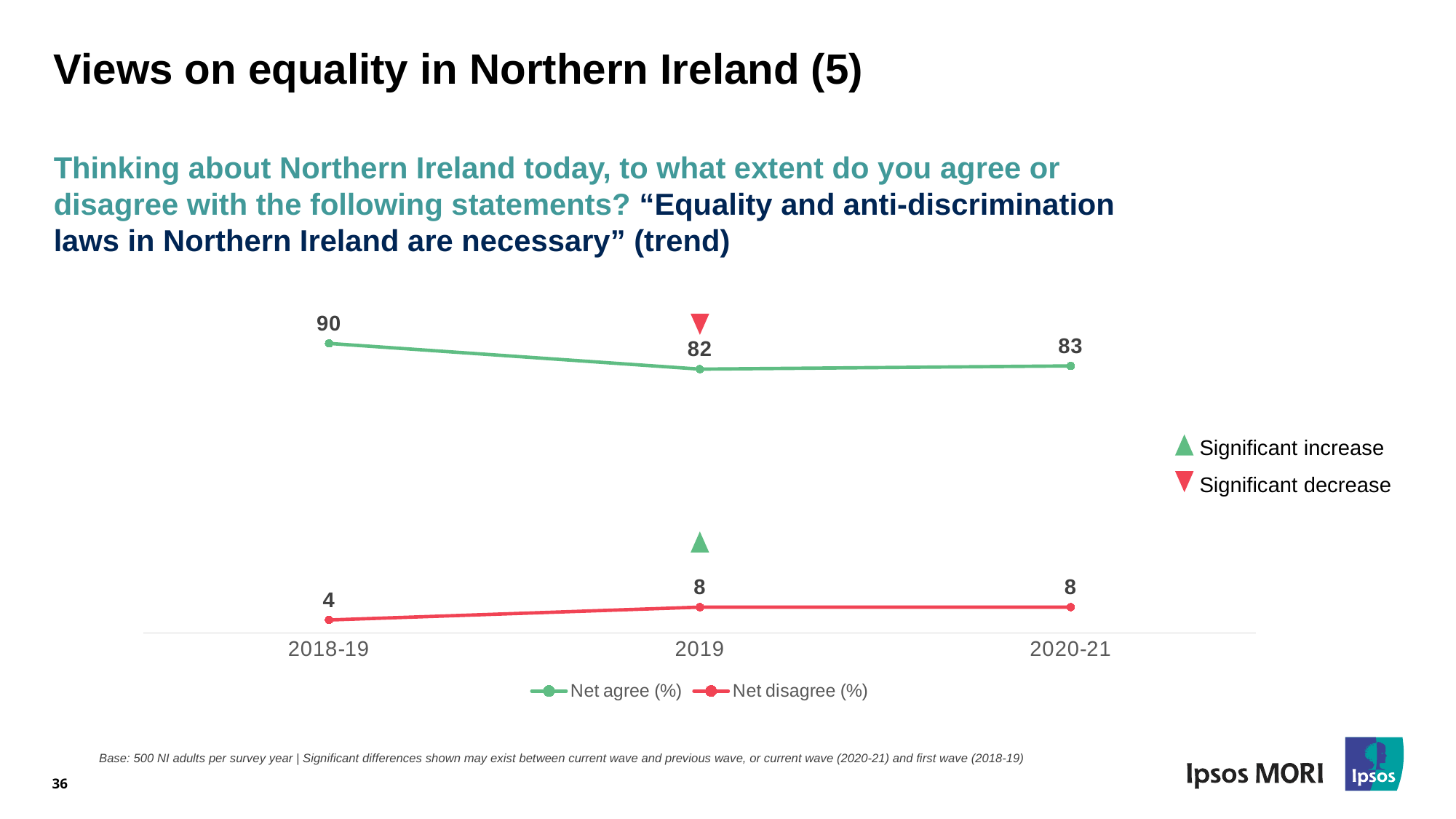
How many series does the legend list? 2 How many years are shown on the x axis? 3 Which is larger, Net disagree (%) in 2018-19 or in 2020-21? 2020-21 What is the difference between Net agree (%) in 2018-19 and 2019? 8 What is the Net agree (%) value for 2020-21? 83 In which year is Net disagree (%) lowest? 2018-19 What is the Net agree (%) value for 2018-19? 90 What is the Net disagree (%) value for 2019? 8 What colour is the Net disagree (%) line? Red Does Net agree (%) rise or fall from 2018-19 to 2019? Fall What kind of chart is shown on the slide? Line chart In which year is Net agree (%) highest? 2018-19